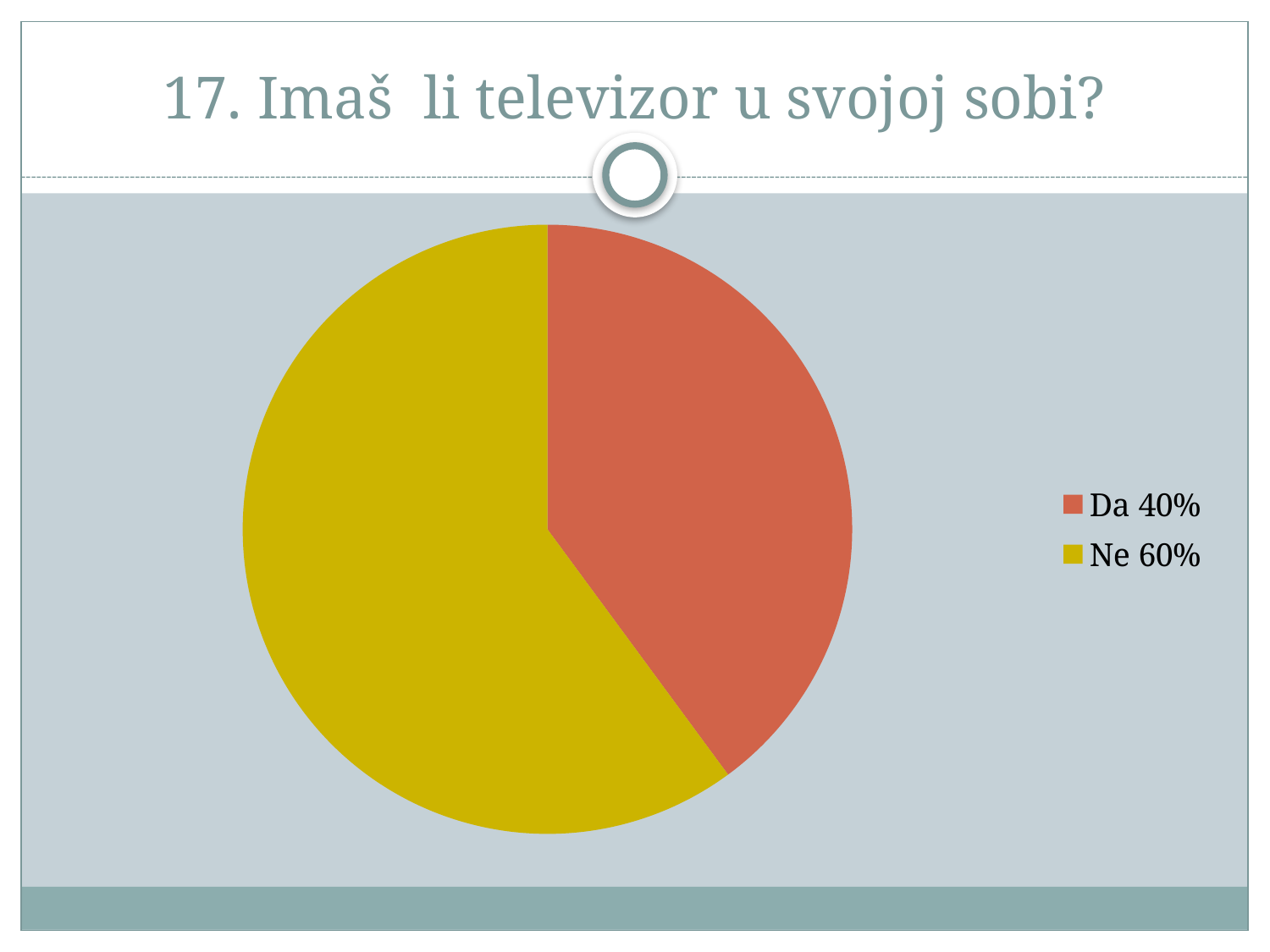
What colour is the slice for "Ne"? yellow What is the title of the slide containing the pie chart? 17. Imaš li televizor u svojoj sobi? What is the difference in percentage points between "Ne" and "Da"? 20% What share of the pie does "Ne" represent? 60% Which category has the largest slice of the pie? Ne What share of the pie does "Da" represent? 40% Which category has the smallest slice of the pie? Da Which is larger, the slice for "Da" or the slice for "Ne"? Ne What kind of chart is shown on the slide? pie chart How many entries does the legend list? 2 How many slices does the pie chart have? 2